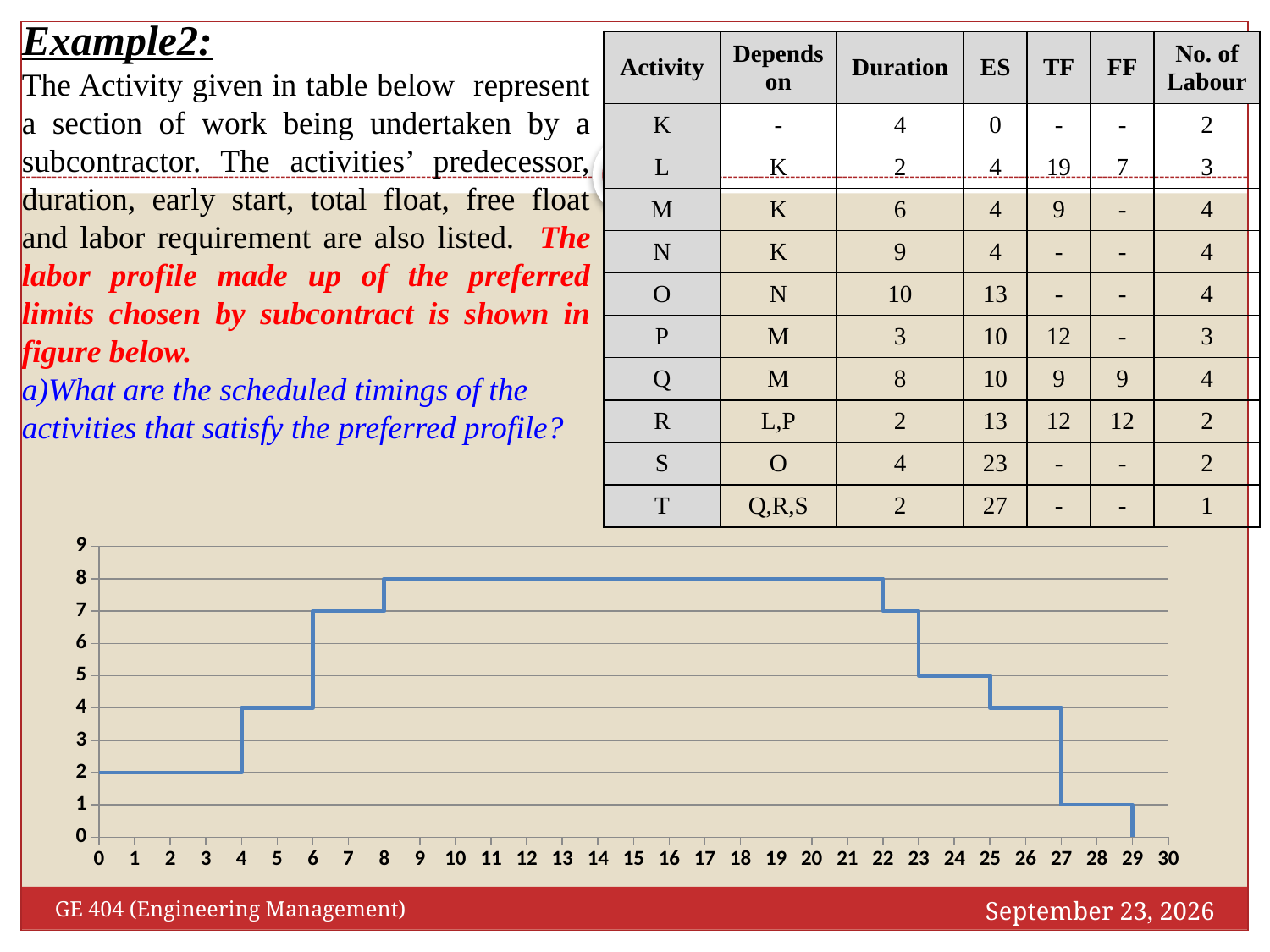
What is the value of the line at x = 15? 8 What is the highest value reached by the line in the chart? 8 What is the value of the line at x = 7? 7 Is the value of the line at x = 26 greater or less than 6? less What is the value of the line at x = 5? 4 What is the value of the line at x = 2? 2 Is the value of the line at x = 10 greater or less than 5? greater What is the value of the line at x = 24? 5 What is the highest value labelled on the y axis of the chart? 9 What kind of chart is shown at the bottom of the slide? line chart Which is larger, the value of the line at x = 3 or at x = 26? x = 26 What is the value of the line at x = 28? 1